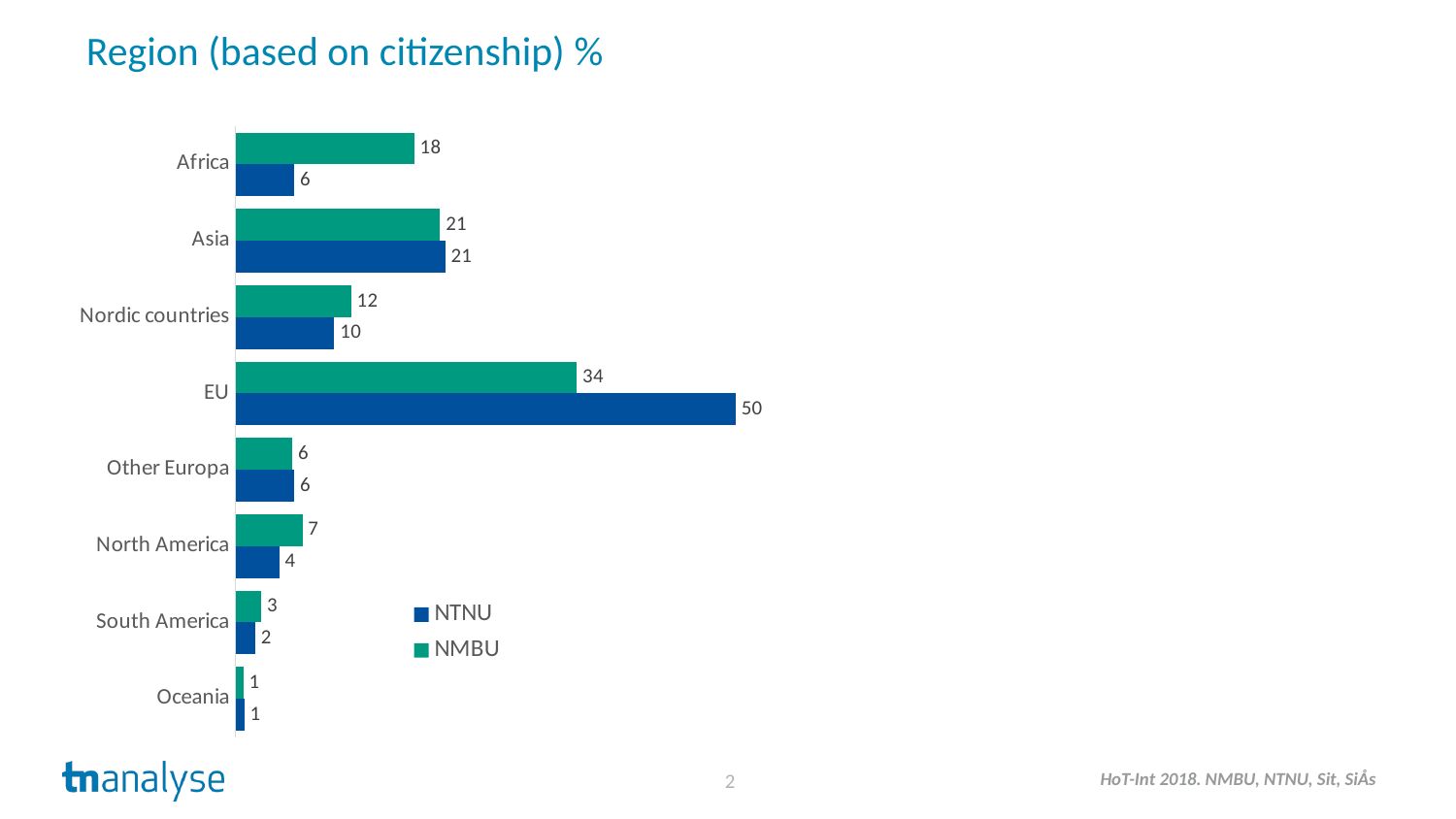
What is the title of the chart? Region (based on citizenship) % Which is larger for North America, the NTNU value or the NMBU value? NMBU What is the NMBU value for Africa? 18 What is the NTNU value for Nordic countries? 10 What kind of chart is shown on the slide? Bar chart What is the difference between the NMBU and NTNU values for Africa? 12 Which region has the highest NMBU value? EU Which region has the lowest NTNU value? Oceania What is the difference between the NTNU and NMBU values for EU? 16 How many series does the legend list? 2 What is the NTNU value for EU? 50 How many regions are shown on the chart? 8